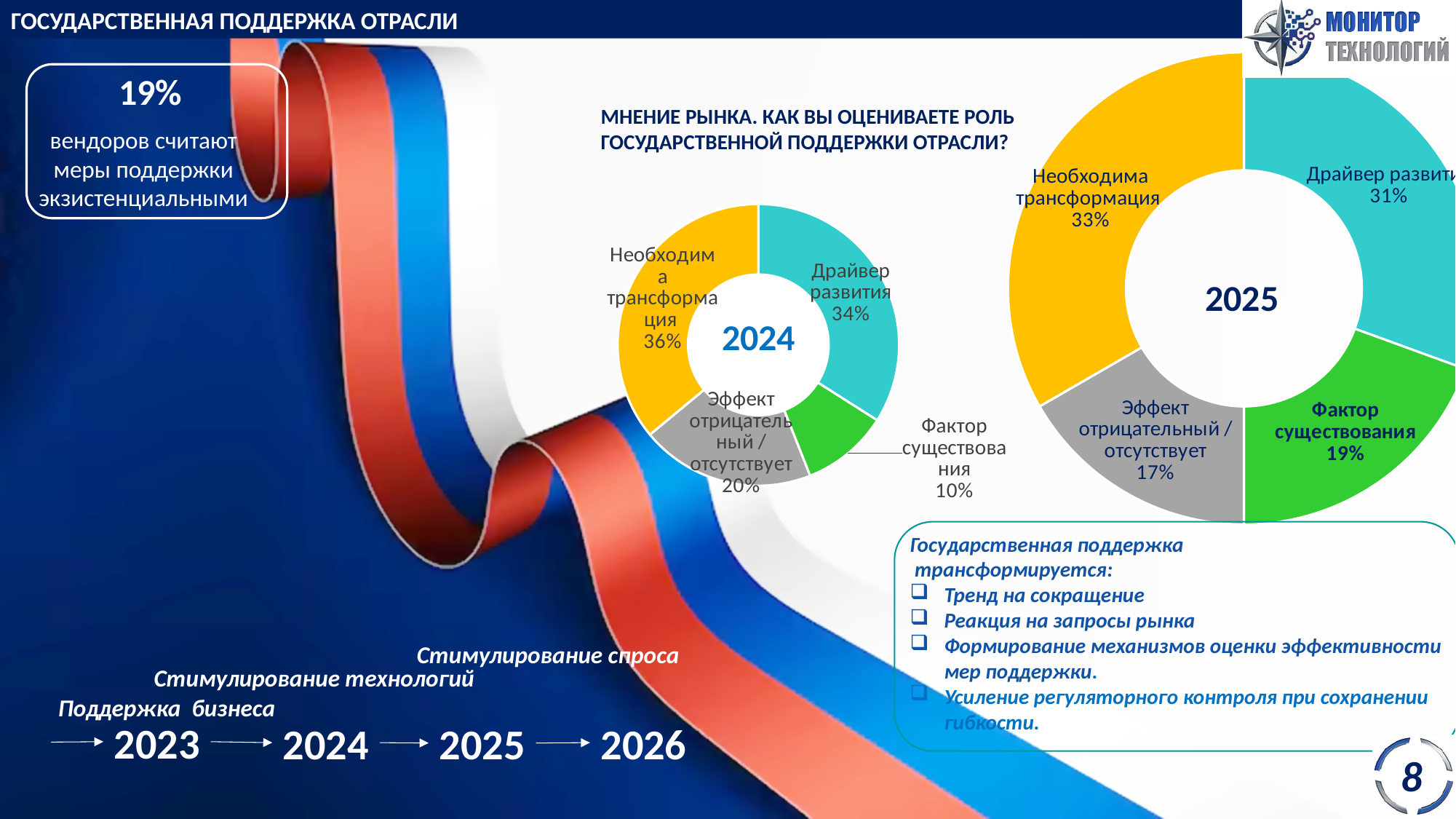
In the 2025 donut chart, what share is labelled for 'Эффект отрицательный / отсутствует'? 17% By how much did the share of 'Фактор существования' change from the 2024 chart to the 2025 chart? Increased by 9% (from 10% to 19%) In the 2025 donut chart, which is larger: 'Фактор существования' or 'Эффект отрицательный / отсутствует'? Фактор существования In the 2025 donut chart, which category has the smallest share? Эффект отрицательный / отсутствует How many categories does the 2025 donut chart show? 4 In the 2025 donut chart, what share is labelled for 'Драйвер развития'? 31% In the 2025 donut chart, what colour is the 'Необходима трансформация' segment? Yellow In the 2024 donut chart, which category has the largest share? Необходима трансформация In the 2024 donut chart, what share is labelled for 'Фактор существования'? 10% What type of chart is used to show the 2024 market opinion data? Donut (pie) chart In the 2024 donut chart, what share is labelled for 'Необходима трансформация'? 36% In the 2024 donut chart, what is the difference between the shares of 'Драйвер развития' and 'Фактор существования'? 24%